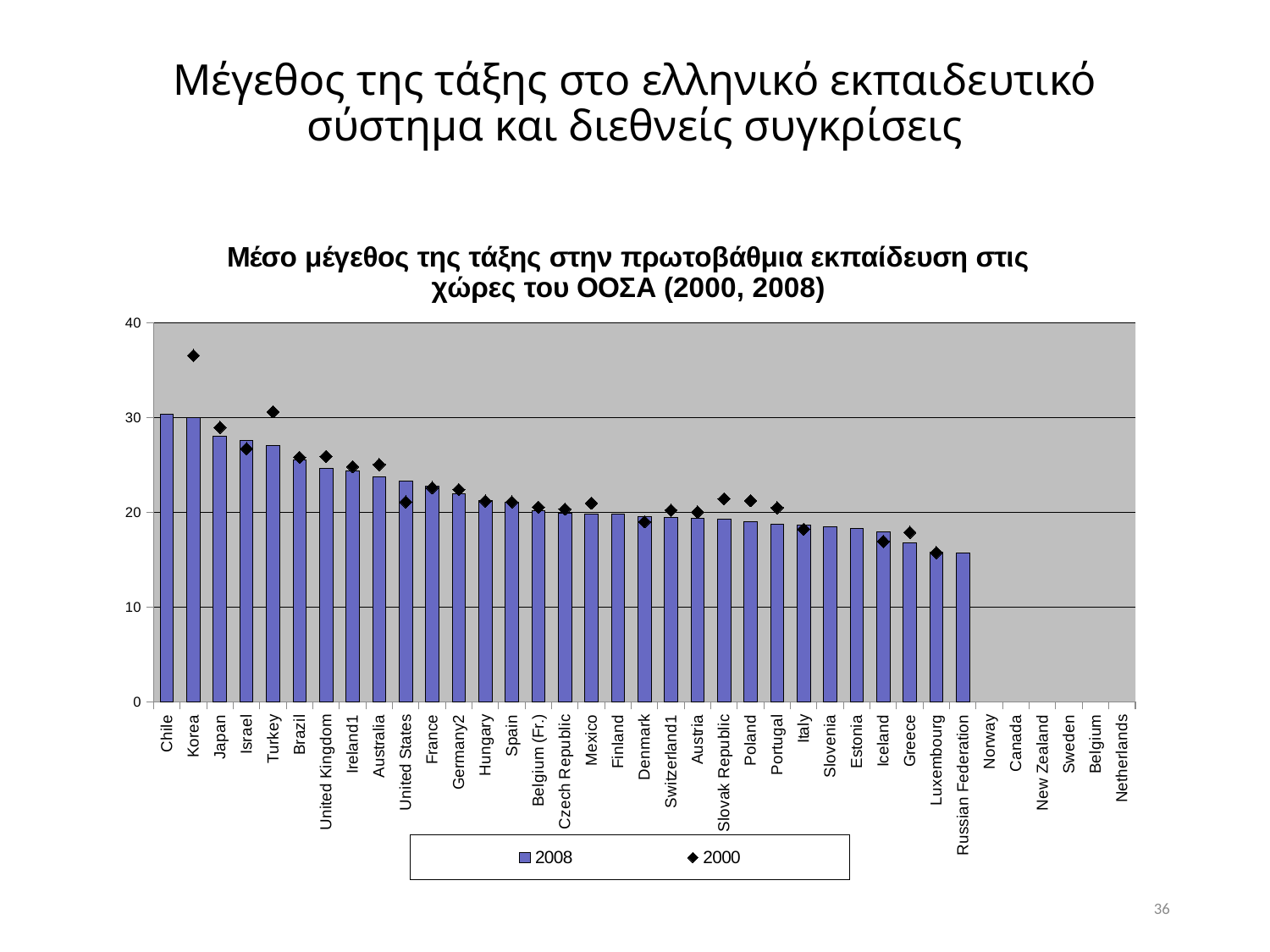
Which series is shown with diamond markers? 2000 Is the 2008 value for Greece greater or less than 20? less Is the 2008 value for Luxembourg greater or less than 10? greater Is the 2008 value for Italy greater or less than 20? less Which country has the highest value for 2000? Korea Do the 2008 bars rise or fall from left to right along the x axis? fall Which two series are listed in the legend? 2008 and 2000 What kind of chart is shown on the slide? bar chart How many series does the legend list? 2